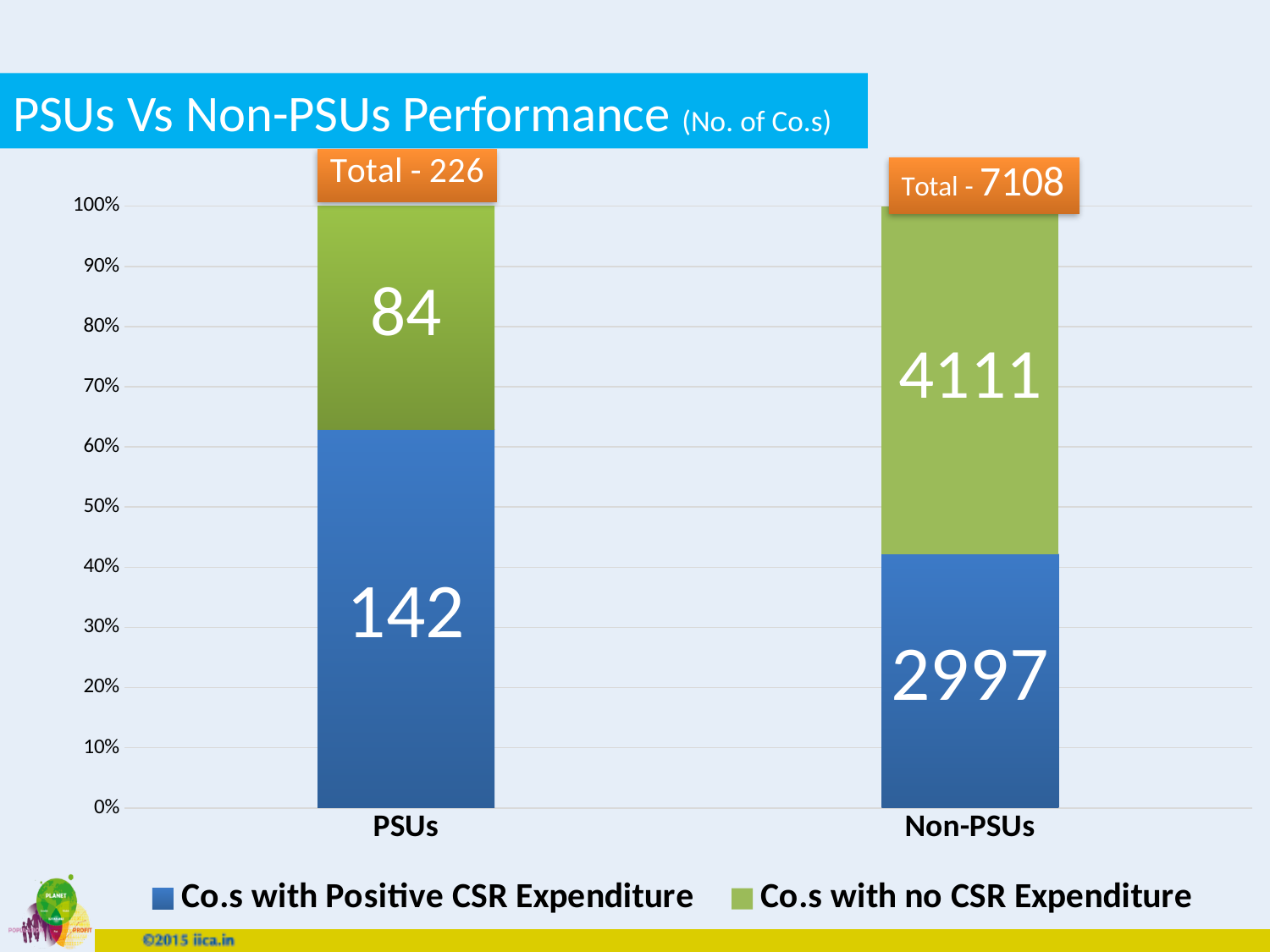
What is the total number of companies shown for the Non-PSUs bar? 7108 How many series does the legend list? 2 Is the share of Non-PSUs with positive CSR expenditure greater or less than 50%? less What is the total number of companies shown for the PSUs bar? 226 What is the number of Non-PSUs with no CSR expenditure? 4111 What is the number of PSUs with no CSR expenditure? 84 Is the share of PSUs with positive CSR expenditure greater or less than 50%? greater What is the number of PSUs with positive CSR expenditure? 142 What is the number of Non-PSUs with positive CSR expenditure? 2997 What type of chart is shown on the slide? Stacked bar chart What is the difference between the number of PSUs with positive CSR expenditure and the number with no CSR expenditure? 58 Which category has more companies with positive CSR expenditure, PSUs or Non-PSUs? Non-PSUs